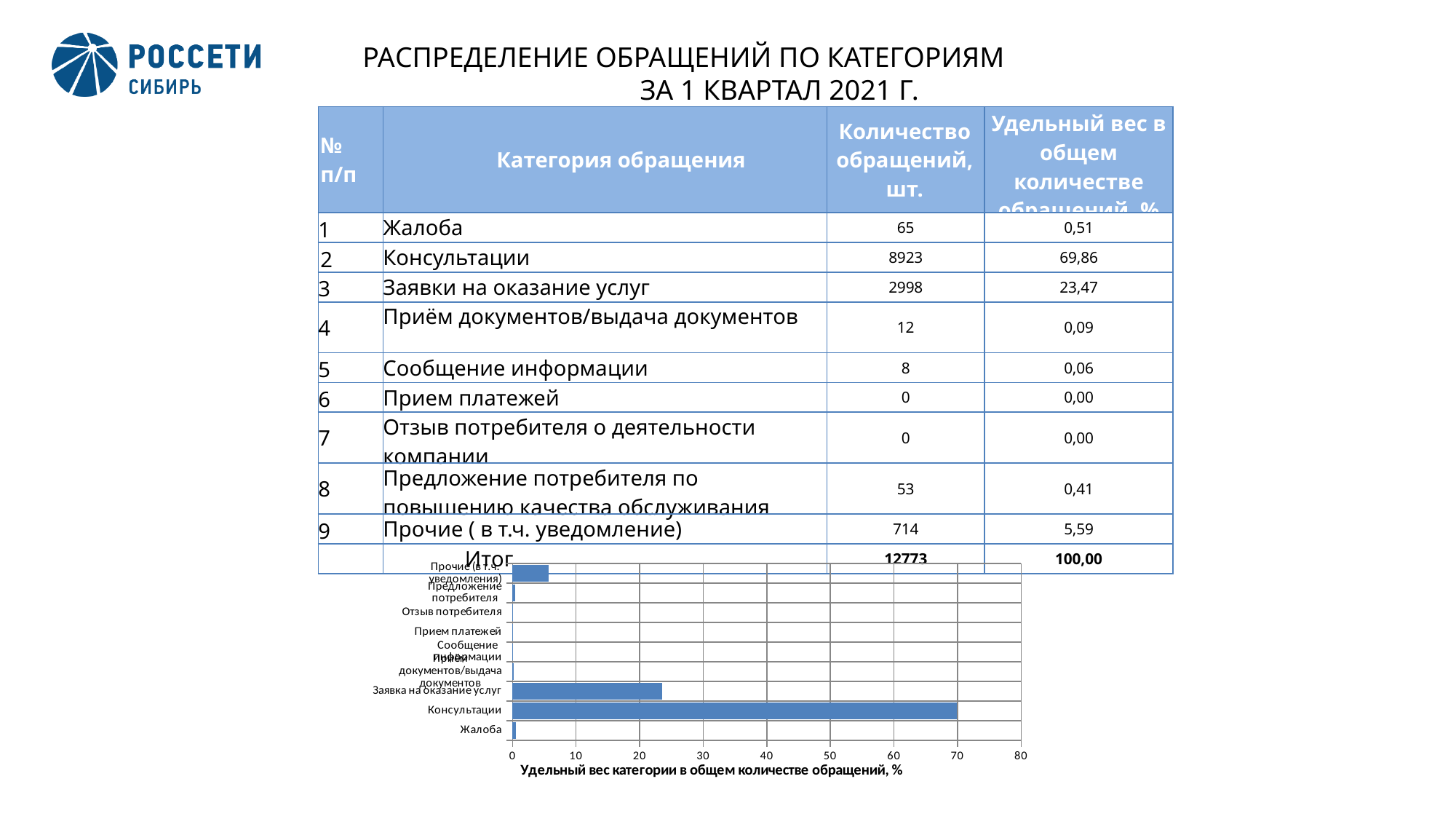
What is the highest tick value shown on the horizontal axis of the chart? 80 Is the value for Заявка на оказание услуг in the chart greater or less than 30? less Is the value for Прочие (в т.ч. уведомления) in the chart greater or less than 10? less In the chart, which bar is longer: Прочие (в т.ч. уведомления) or Жалоба? Прочие (в т.ч. уведомления) Is the value for Консультации in the chart greater or less than 60? greater In the chart, which bar is longer: Консультации or Заявка на оказание услуг? Консультации What kind of chart is shown at the bottom of the slide? bar chart Which category has the longest bar in the chart? Консультации What is the title of the horizontal axis of the chart? Удельный вес категории в общем количестве обращений, % How many categories are plotted in the bar chart? 9